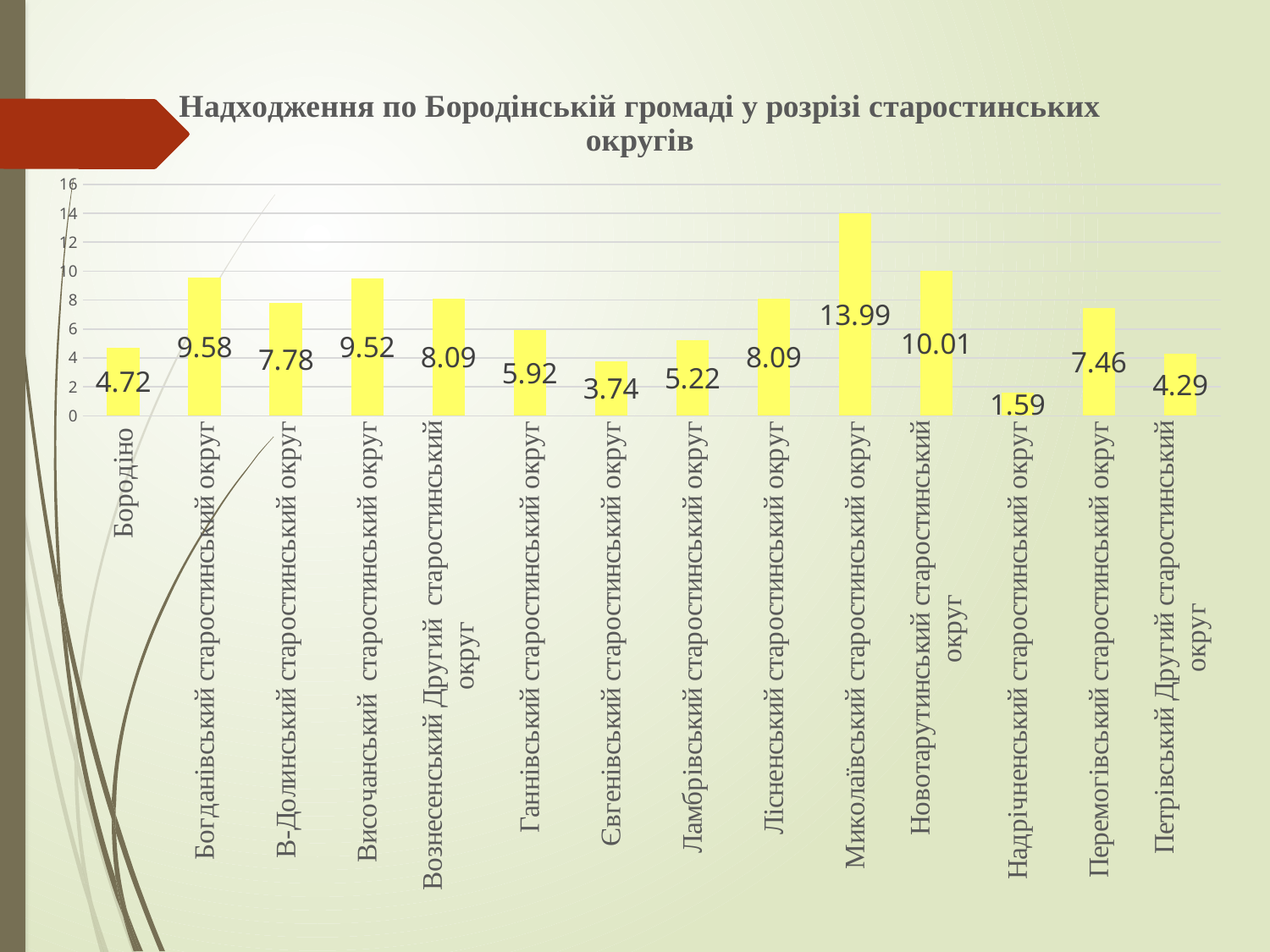
Which is larger, the value for Богданівський старостинський округ or the value for В-Долинський старостинський округ? Богданівський старостинський округ What is the value for Надрічненський старостинський округ? 1.59 Is the value for Євгенівський старостинський округ greater or less than 4? less What is the value for Бородіно? 4.72 What kind of chart is shown on the slide? bar chart What is the title of the chart? Надходження по Бородінській громаді у розрізі старостинських округів Which category has the highest value? Миколаївський старостинський округ What is the difference between the values for Миколаївський старостинський округ and Новотарутинський старостинський округ? 3.98 What is the value for Новотарутинський старостинський округ? 10.01 Which category has the lowest value? Надрічненський старостинський округ What is the value for Миколаївський старостинський округ? 13.99 How many categories are shown on the chart? 14